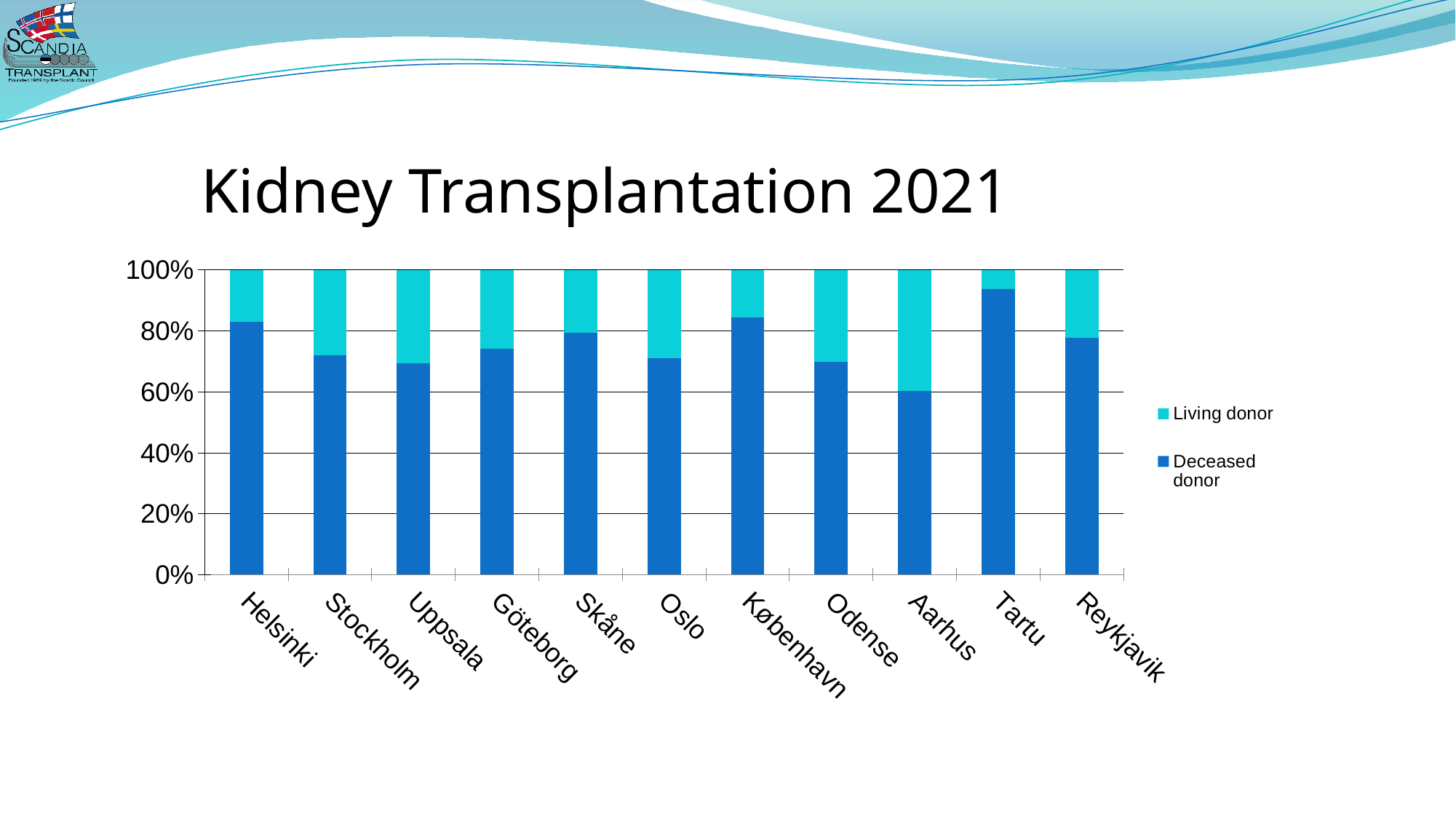
How many centres (categories) are shown on the x axis? 11 Is the deceased donor share for Tartu greater or less than 80%? greater Which has a larger deceased donor share, Helsinki or Uppsala? Helsinki What does each stacked bar total to? 100% How many series does the legend list? 2 Which centre has the largest share of living donor transplants? Aarhus Is the deceased donor share for Aarhus greater or less than 80%? less What kind of chart is shown on the slide? Stacked bar chart Which centre has the lowest share of deceased donor transplants? Aarhus Is the deceased donor share for Uppsala greater or less than 80%? less Which centre has the highest share of deceased donor transplants? Tartu What is the title of the chart? Kidney Transplantation 2021